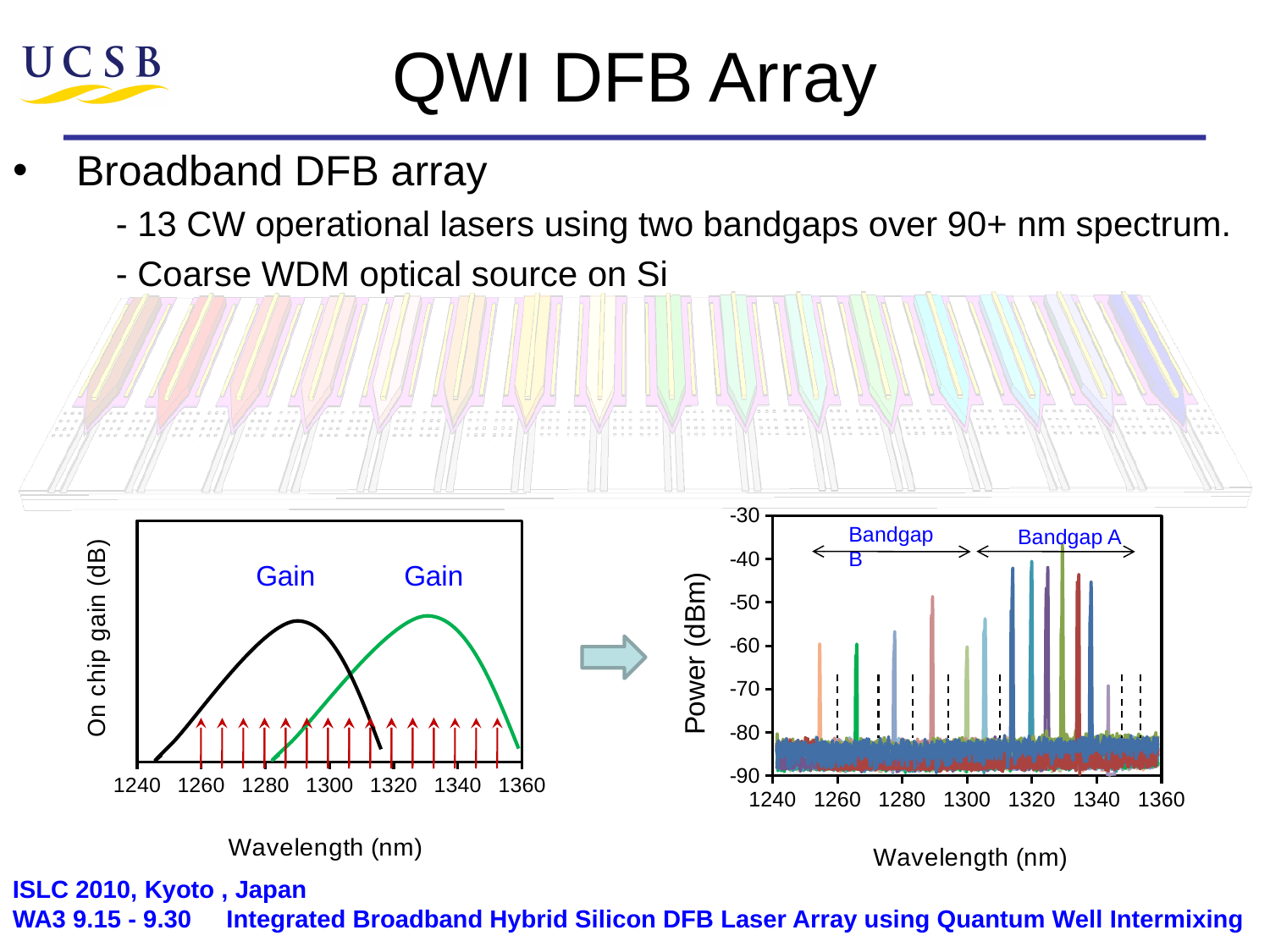
On the right-hand chart, which bandgap region covers the longer wavelengths, Bandgap A or Bandgap B? Bandgap A On the left-hand chart, which gain curve peaks at the longer wavelength, the black one or the green one? green On the right-hand chart, what is the highest value shown on the y axis? -30 On the right-hand chart, is the peak near 1313 nm greater or less than -60 dBm? greater On the right-hand chart, is the tallest laser peak greater or less than -50 dBm? greater On the left-hand chart, what is the label of the y axis? On chip gain (dB) On the left-hand chart, what are the minimum and maximum wavelengths shown on the x axis? 1240 and 1360 On the right-hand chart, what is the lowest value shown on the y axis? -90 On the right-hand chart, is the noise floor greater or less than -80 dBm? less On the left-hand chart, how many gain curves are plotted? 2 On the right-hand chart, what is the label of the y axis? Power (dBm) What kind of chart is the right-hand chart (Power vs Wavelength)? line chart